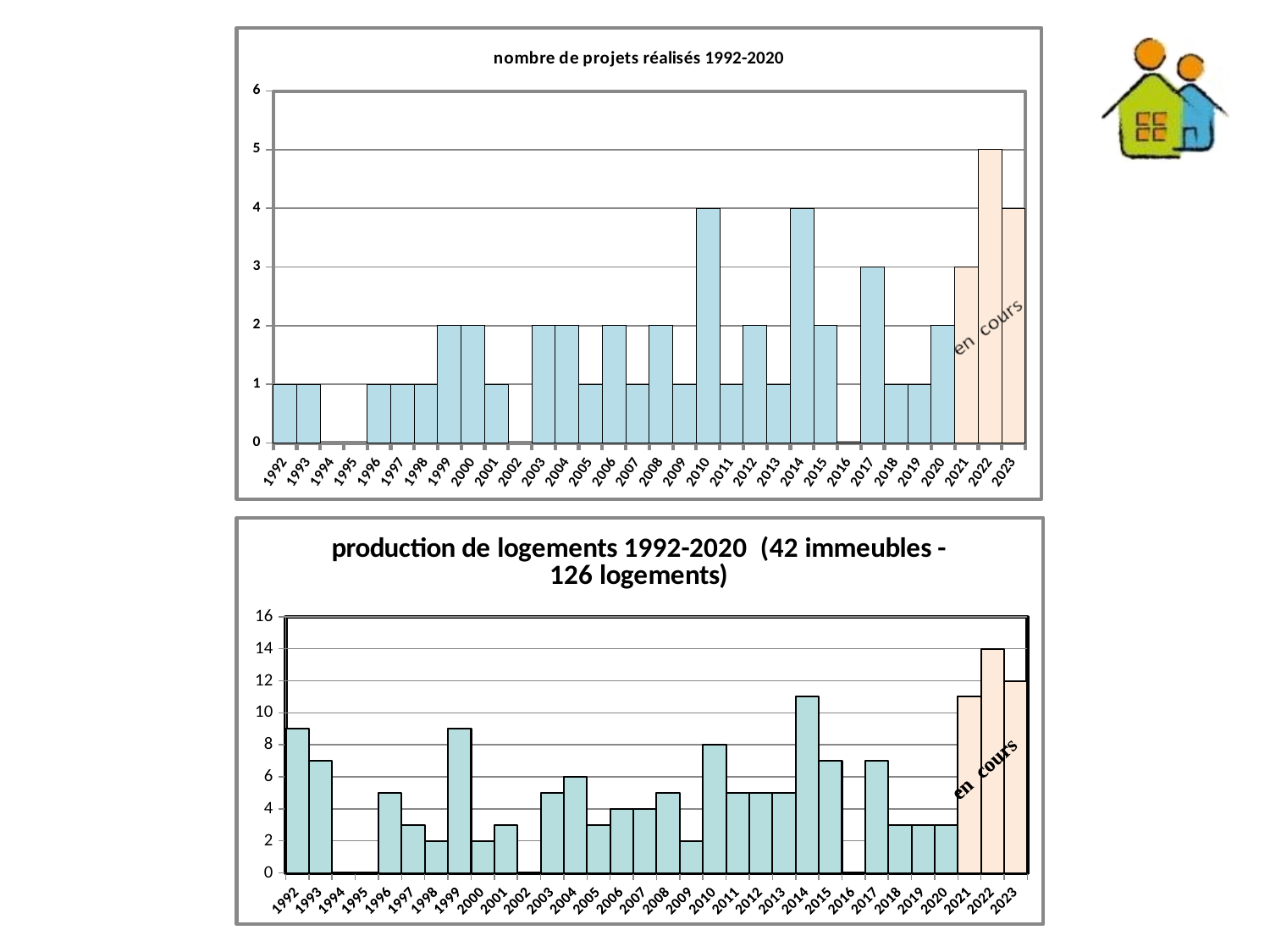
On the bottom chart, what is the value for 2010? 8 On the top chart, which year has the highest bar? 2022 What is the title of the top chart? nombre de projets réalisés 1992-2020 On the top chart, what is the difference between the values for 2022 and 2017? 2 On the top chart, which is larger, the value for 2014 or the value for 2015? 2014 On the bottom chart, is the value for 2014 greater or less than 10? greater On the bottom chart, what is the value for 2022? 14 On the top chart, what is the number of projects for 2022? 5 On the bottom chart, which year has the highest bar? 2022 On the top chart, what is the number of projects for 2010? 4 On the top chart, how many years are shown on the x axis? 32 What kind of chart is the top chart? bar chart